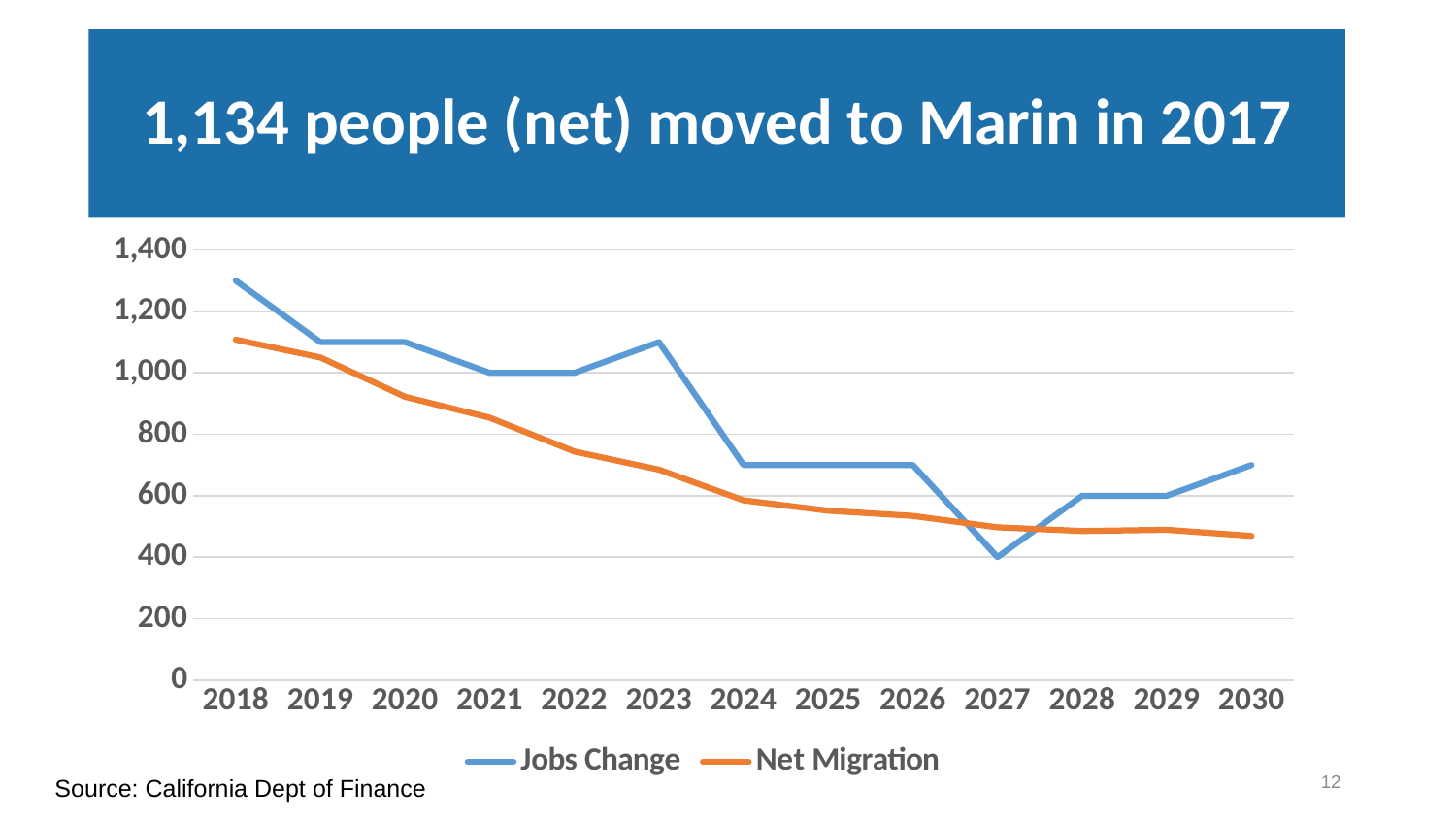
How many years are plotted along the x axis? 13 Is the Net Migration value for 2020 greater or less than 800? greater What kind of chart is shown on the slide? line chart In 2027, which series has the larger value, Jobs Change or Net Migration? Net Migration Is the Net Migration value for 2030 greater or less than 600? less How many series does the legend list? 2 Does the Net Migration line generally rise or fall from 2018 to 2030? fall Which year has the highest Net Migration value? 2018 Is the Jobs Change value for 2018 greater or less than 1,200? greater In 2018, which series has the larger value, Jobs Change or Net Migration? Jobs Change Which year has the lowest Jobs Change value? 2027 Which year has the highest Jobs Change value? 2018